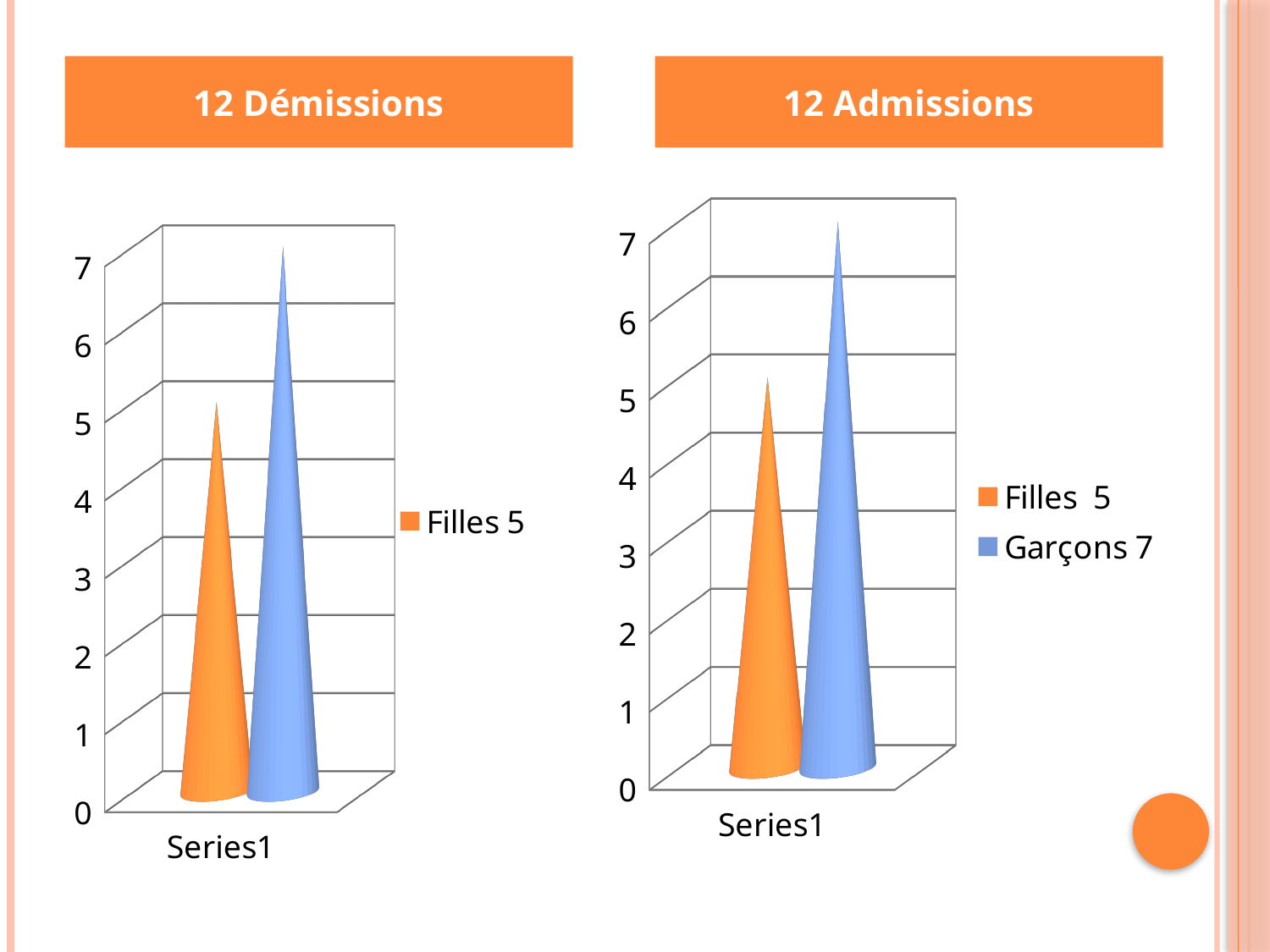
What kind of chart is the '12 Démissions' chart? bar chart In the '12 Admissions' chart, which is larger, Filles or Garçons? Garçons How many series does the legend of the '12 Démissions' chart list? 1 How many series does the legend of the '12 Admissions' chart list? 2 What is the x-axis category label shown in the '12 Admissions' chart? Series1 In the '12 Admissions' chart, which series has the lowest value? Filles In the '12 Admissions' chart, what value does the legend give for Filles? 5 In the '12 Démissions' chart, is the value of the blue cone greater or less than 6? greater In the '12 Démissions' chart, what value does the legend give for Filles? 5 In the '12 Admissions' chart, which series has the highest value? Garçons In the '12 Admissions' chart, what is the difference between Garçons and Filles? 2 In the '12 Admissions' chart, what value does the legend give for Garçons? 7